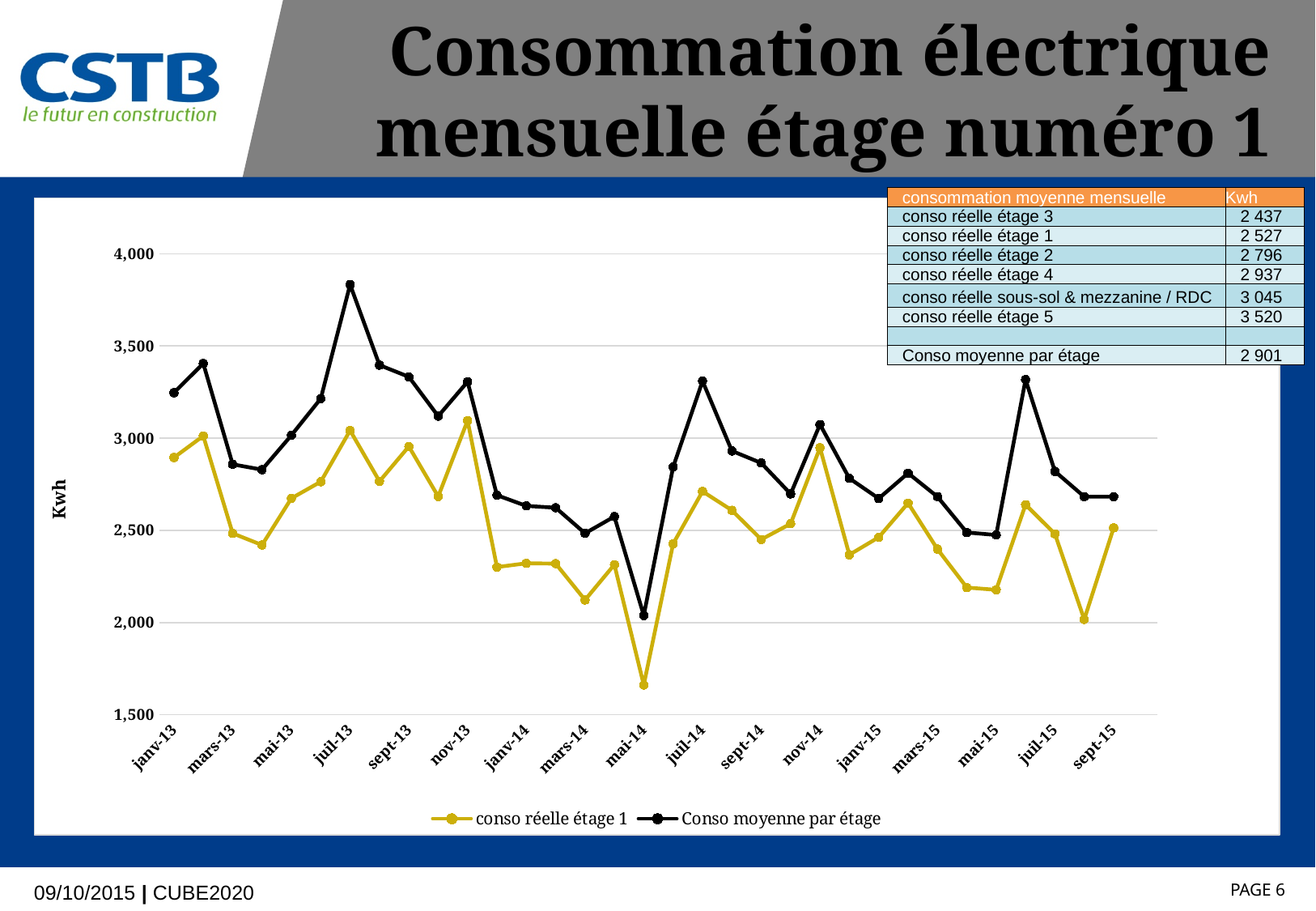
Is the value for conso réelle étage 1 in mai-14 greater or less than 2,000? less Which series has the higher value in juil-13, conso réelle étage 1 or Conso moyenne par étage? Conso moyenne par étage What kind of chart is shown on the slide? line chart What is the label on the vertical axis of the chart? Kwh What are the two series named in the chart legend? conso réelle étage 1 and Conso moyenne par étage For Conso moyenne par étage, which month has the higher value, juil-13 or juil-14? juil-13 In which month does the Conso moyenne par étage series reach its highest value? juil-13 How many series does the chart legend list? 2 Is the value for Conso moyenne par étage in juil-13 greater or less than 3,500? greater In which month does the Conso moyenne par étage series reach its lowest value? mai-14 In which month does the conso réelle étage 1 series reach its lowest value? mai-14 Is the value for Conso moyenne par étage in janv-13 greater or less than 3,000? greater